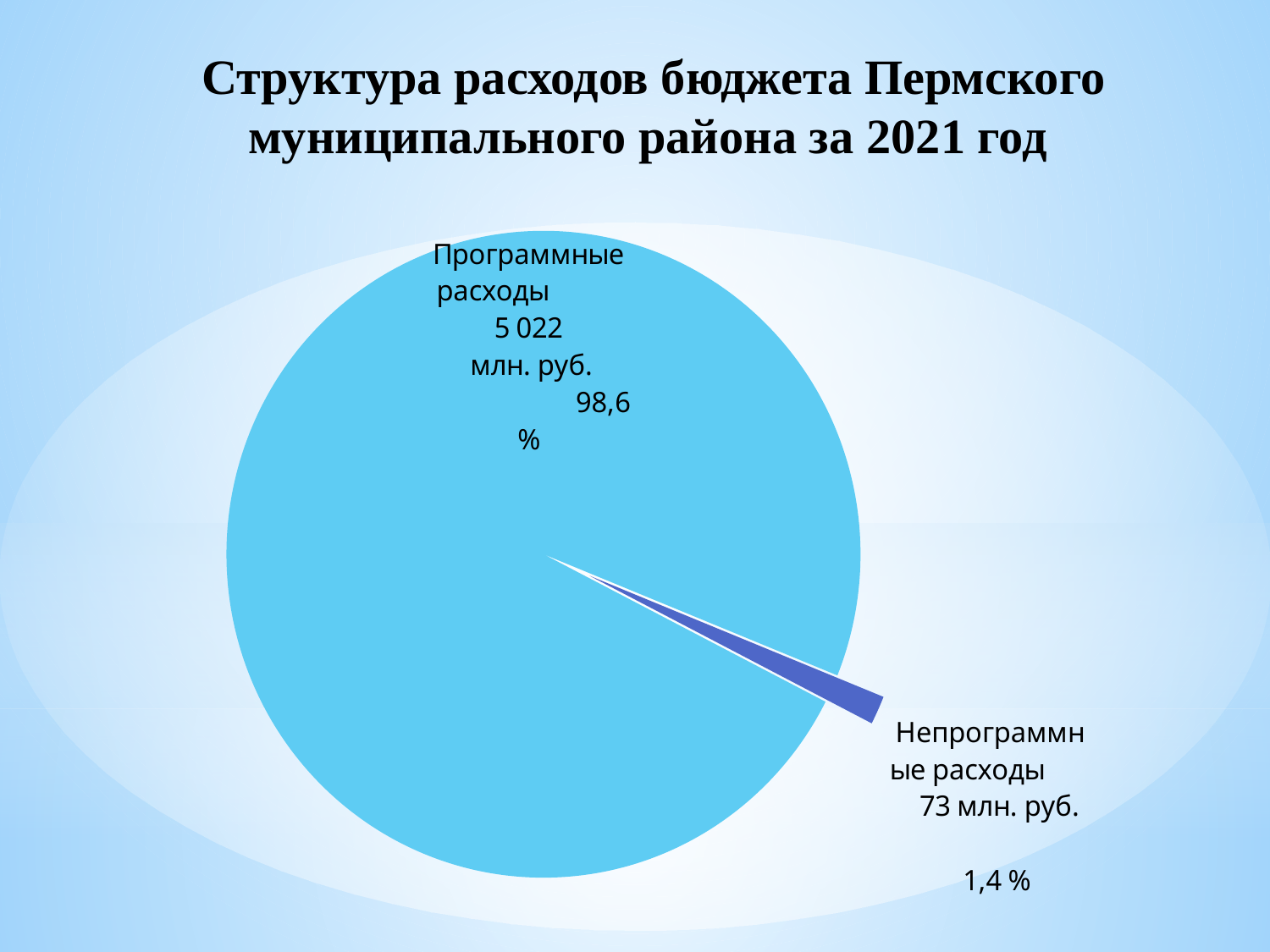
What is the title of the slide? Структура расходов бюджета Пермского муниципального района за 2021 год Which is larger, Программные расходы or Непрограммные расходы? Программные расходы What colour is the slice for Непрограммные расходы? dark blue Which category has the smallest slice? Непрограммные расходы What share of the pie is Программные расходы? 98,6 % What share of the pie is Непрограммные расходы? 1,4 % How many slices does the pie chart have? 2 What is the value for Непрограммные расходы? 73 млн. руб. What kind of chart is shown on the slide? pie chart Which category has the largest slice? Программные расходы What is the difference in млн. руб. between Программные расходы and Непрограммные расходы? 4 949 млн. руб. What is the value for Программные расходы? 5 022 млн. руб.